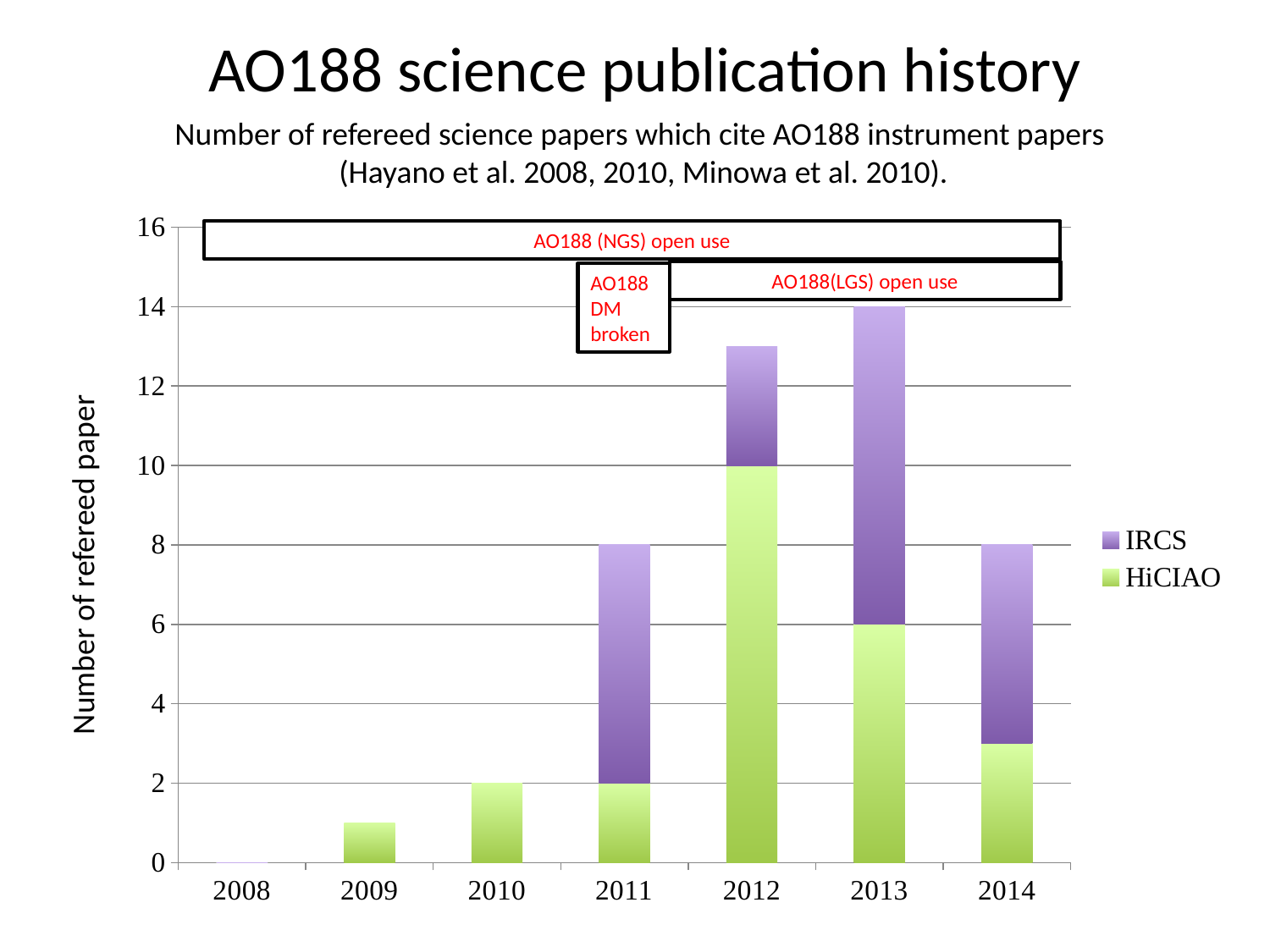
How many years are shown on the x axis? 7 Is the total value for 2012 greater or less than 12? greater What is the HiCIAO value for 2013? 6 How many series does the legend list? 2 Which year has the highest total number of refereed papers? 2013 Do the total values rise or fall from 2009 to 2013? rise Which is larger, the total for 2012 or the total for 2014? 2012 What is the HiCIAO value for 2012? 10 What kind of chart is shown on the slide? bar chart What is the total number of refereed papers in 2011? 8 What is the total number of refereed papers in 2013? 14 What is the difference between the total for 2013 and the total for 2011? 6